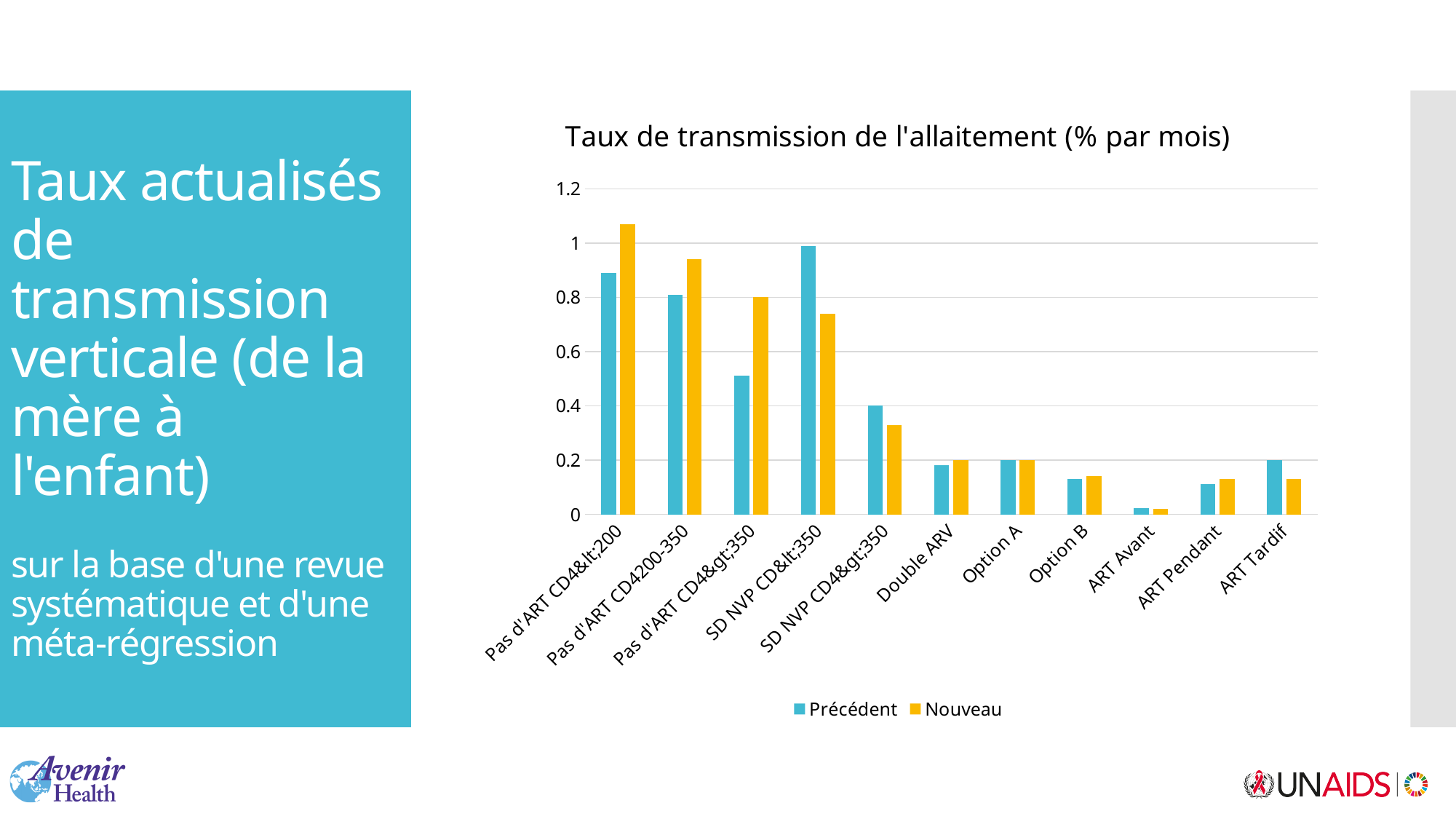
What kind of chart is shown on the slide? bar chart Which category has the highest Nouveau value? Pas d'ART CD4&lt;200 Is the Nouveau value for SD NVP CD4&gt;350 greater or less than 0.4? less Is the Nouveau value for SD NVP CD4&lt;350 greater or less than 0.8? less What is the title of the chart? Taux de transmission de l'allaitement (% par mois) How many categories are shown on the x axis? 11 Which category has the lowest Nouveau value? ART Avant Which series is shown in orange? Nouveau Which category has the highest Précédent value? SD NVP CD&lt;350 How many series does the legend list? 2 For Pas d'ART CD4&gt;350, which is larger: the Précédent value or the Nouveau value? Nouveau Is the Nouveau value for Pas d'ART CD4&lt;200 greater or less than 1? greater